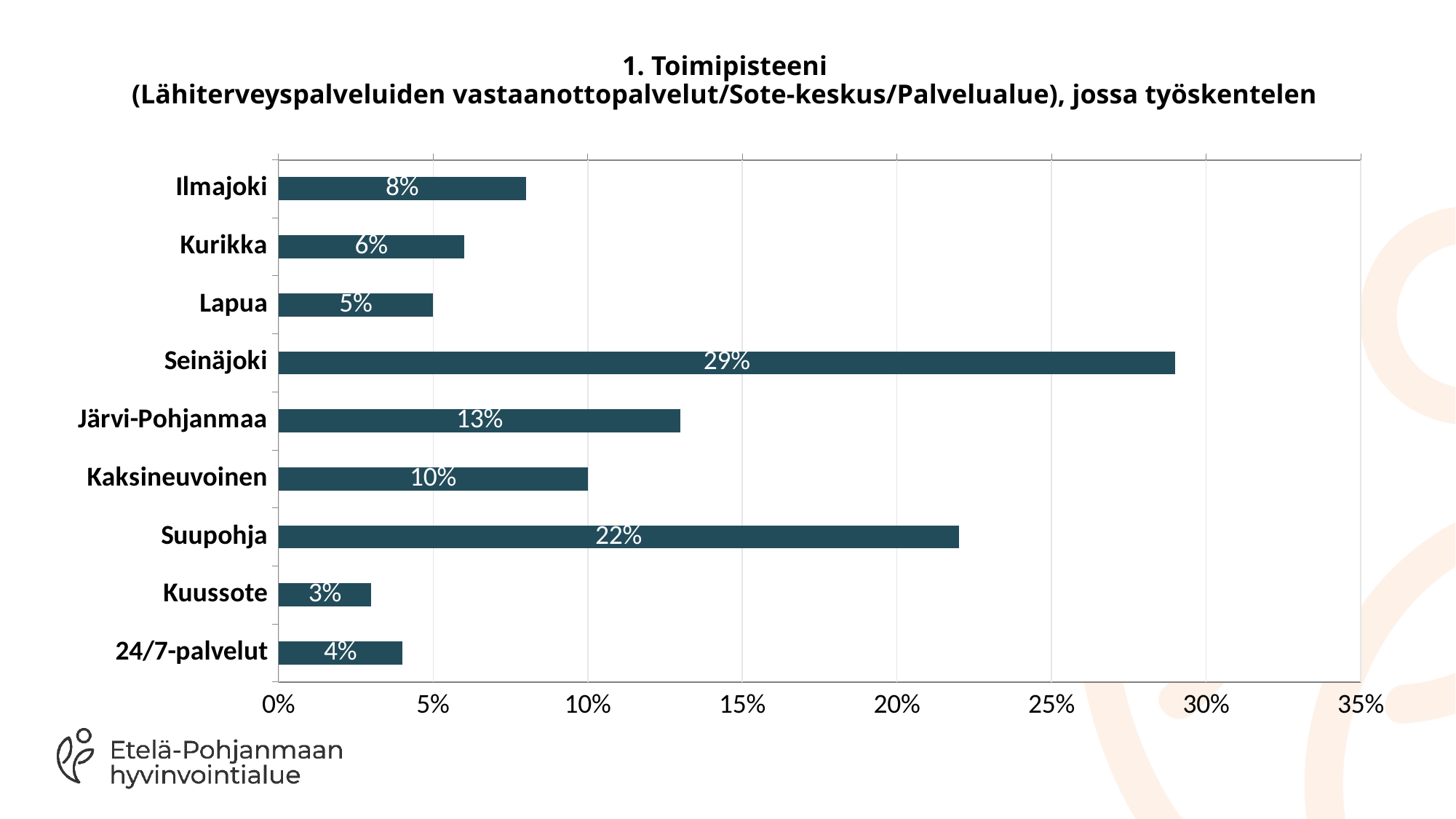
What is the value for 24/7-palvelut? 4% Which is larger, the value for Ilmajoki or the value for Kurikka? Ilmajoki Which category has the highest value? Seinäjoki What kind of chart is shown on the slide? bar chart Is the value for Suupohja greater or less than 20%? greater What is the value for Kaksineuvoinen? 10% What is the difference between the values for Seinäjoki and Suupohja? 7% What is the value for Seinäjoki? 29% What is the difference between the values for Järvi-Pohjanmaa and Lapua? 8% What is the highest value shown on the x axis? 35% Which category has the lowest value? Kuussote How many categories are shown in the chart? 9